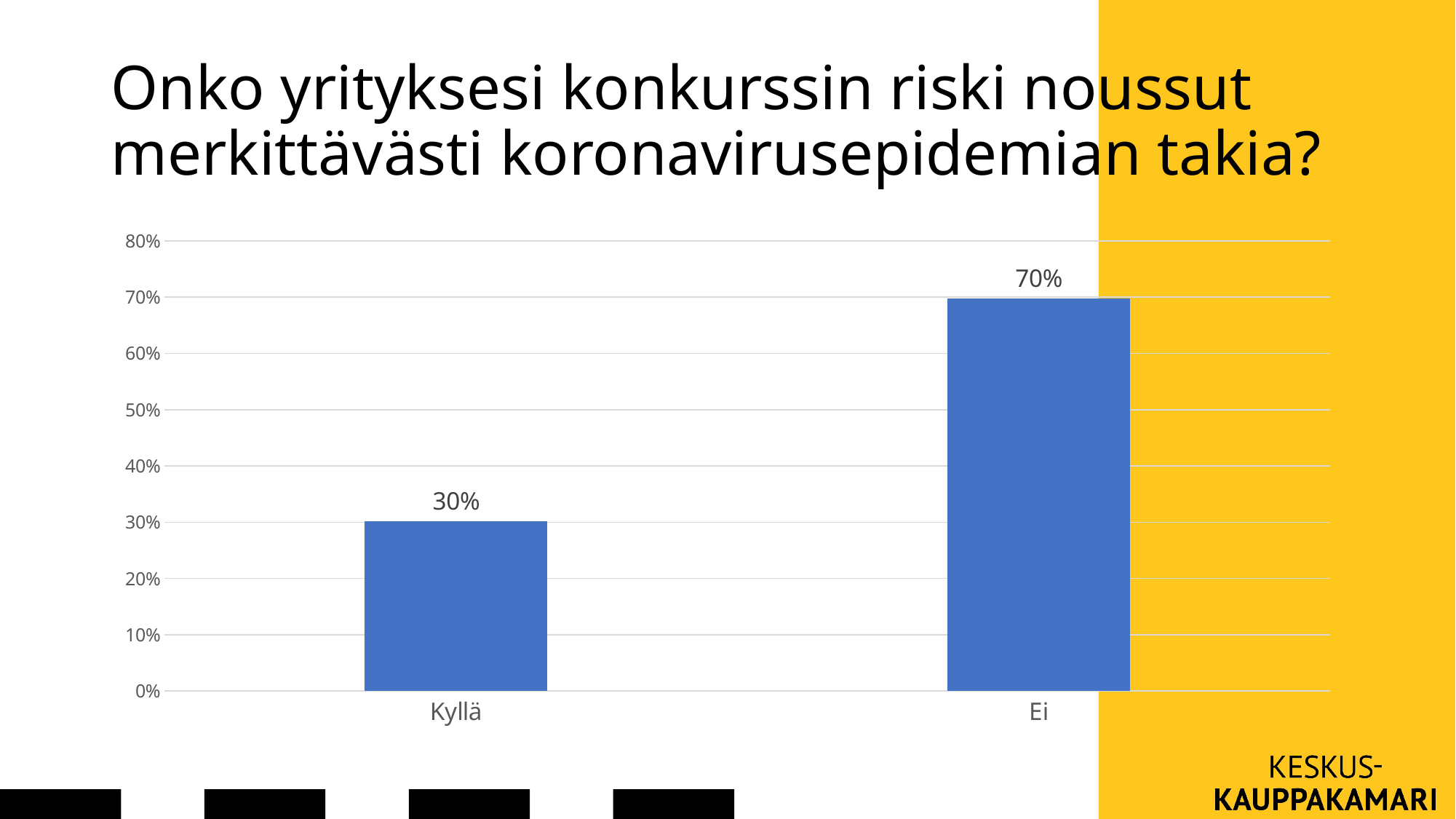
Which category has the lowest value? Kyllä Which category has the highest value? Ei What kind of chart is shown on the slide? bar chart What is the title of the chart? Onko yrityksesi konkurssin riski noussut merkittävästi koronavirusepidemian takia? What is the value for Kyllä? 30% What is the highest value shown on the y axis? 80% Which is larger, the value for Kyllä or the value for Ei? Ei How many categories are shown on the x axis? 2 What is the difference between the values for Ei and Kyllä? 40% Is the value for Ei greater or less than 50%? greater Is the value for Kyllä greater or less than 40%? less What is the value for Ei? 70%